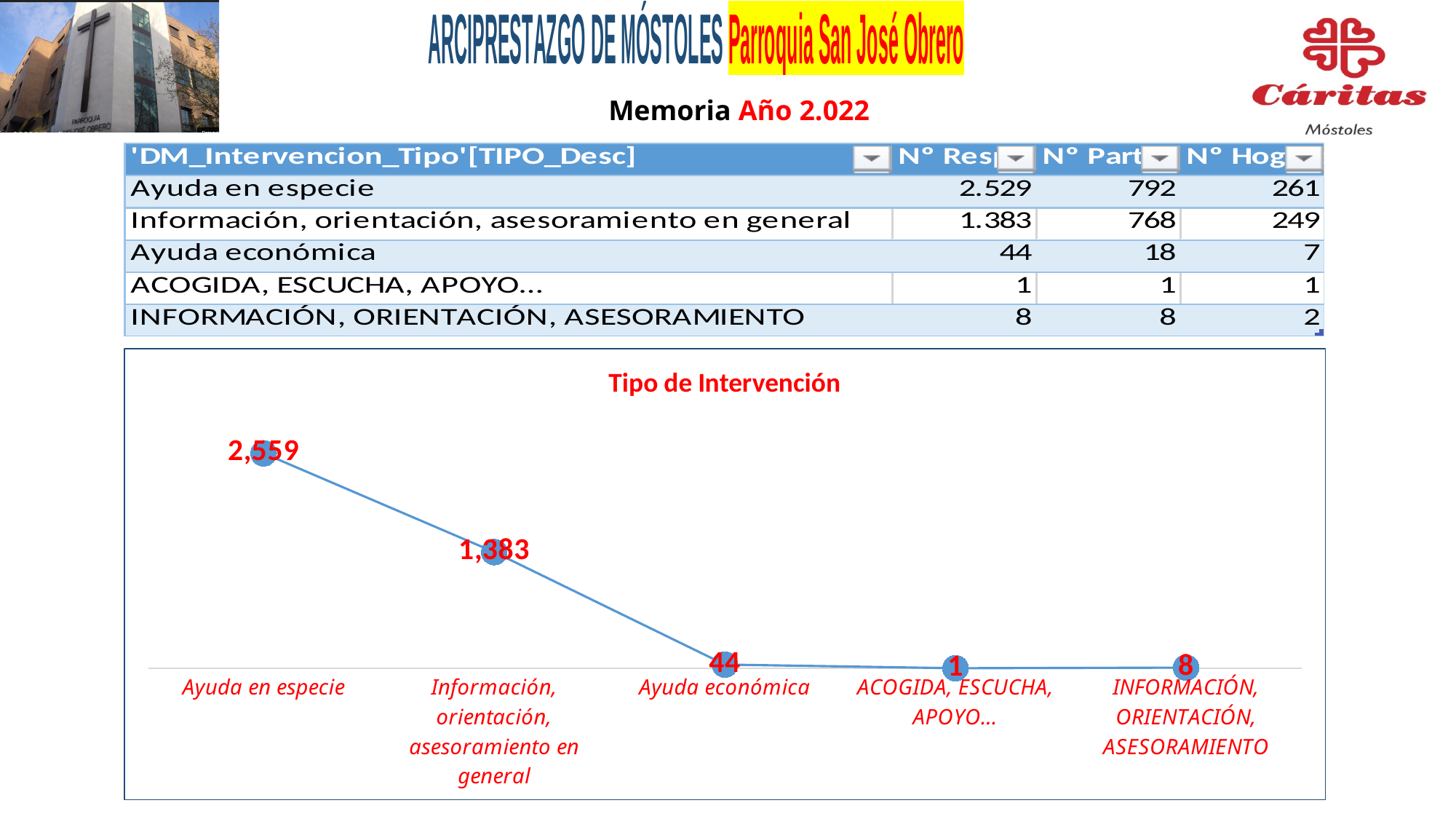
Which category has the highest value on the "Tipo de Intervención" chart? Ayuda en especie On the "Tipo de Intervención" chart, what is the difference between the values for "Ayuda económica" and "INFORMACIÓN, ORIENTACIÓN, ASESORAMIENTO"? 36 What is the value plotted for "INFORMACIÓN, ORIENTACIÓN, ASESORAMIENTO" on the "Tipo de Intervención" chart? 8 On the "Tipo de Intervención" chart, what is the difference between the values for "Información, orientación, asesoramiento en general" and "Ayuda económica"? 1,339 What kind of chart is shown under the title "Tipo de Intervención"? Line chart Which category has the lowest value on the "Tipo de Intervención" chart? ACOGIDA, ESCUCHA, APOYO... On the "Tipo de Intervención" chart, which is larger: the value for "Ayuda económica" or the value for "INFORMACIÓN, ORIENTACIÓN, ASESORAMIENTO"? Ayuda económica What is the value plotted for "Información, orientación, asesoramiento en general" on the "Tipo de Intervención" chart? 1,383 What is the value plotted for "Ayuda económica" on the "Tipo de Intervención" chart? 44 What is the value plotted for "ACOGIDA, ESCUCHA, APOYO..." on the "Tipo de Intervención" chart? 1 What is the title of the chart on the slide? Tipo de Intervención How many categories are plotted on the "Tipo de Intervención" chart? 5